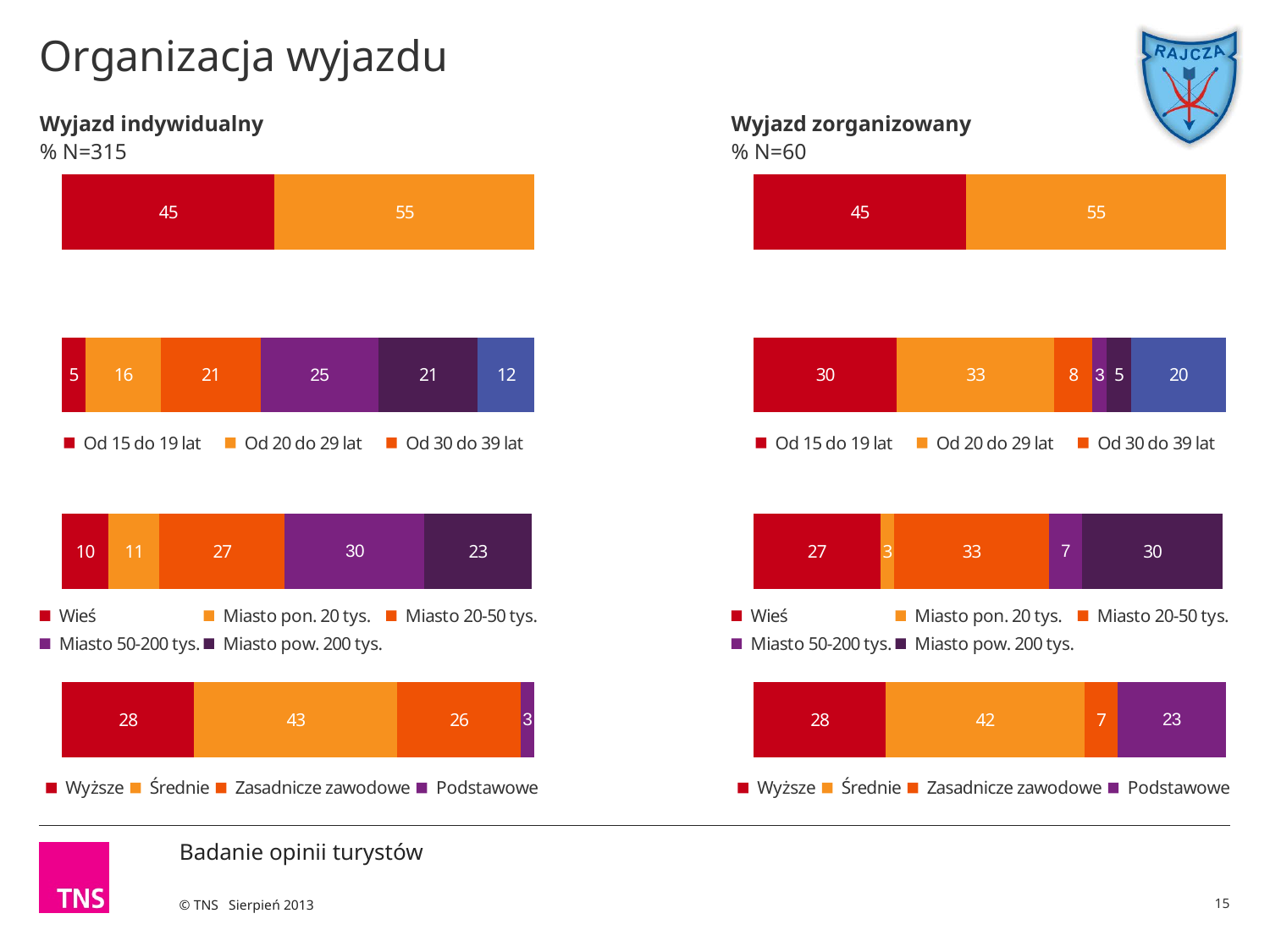
In the education chart (bottom bar) under "Wyjazd indywidualny", which category has the smallest value? Podstawowe In the place-of-residence chart (third bar) under "Wyjazd indywidualny", which category has the largest value? Miasto 50-200 tys. In the place-of-residence chart (third bar) under "Wyjazd indywidualny", which is larger: Wieś or Miasto 20-50 tys.? Miasto 20-50 tys. In the age chart (second bar) under "Wyjazd indywidualny", what is the value for Od 20 do 29 lat? 16 What is the total of the education bar (bottom bar) under "Wyjazd indywidualny"? 100 In the place-of-residence chart (third bar) under "Wyjazd zorganizowany", what is the value for Miasto pow. 200 tys.? 30 In the education chart (bottom bar) under "Wyjazd indywidualny", what is the value for Średnie? 43 In the education chart (bottom bar) under "Wyjazd zorganizowany", what is the difference between Średnie and Podstawowe? 19 How many entries does the legend of the place-of-residence chart (third bar) under "Wyjazd zorganizowany" list? 5 What kind of chart is used for the education breakdown under "Wyjazd zorganizowany"? Stacked bar chart How many segments does the education bar (bottom bar) under "Wyjazd indywidualny" have? 4 In the age chart (second bar) under "Wyjazd zorganizowany", what is the value for Od 15 do 19 lat? 30